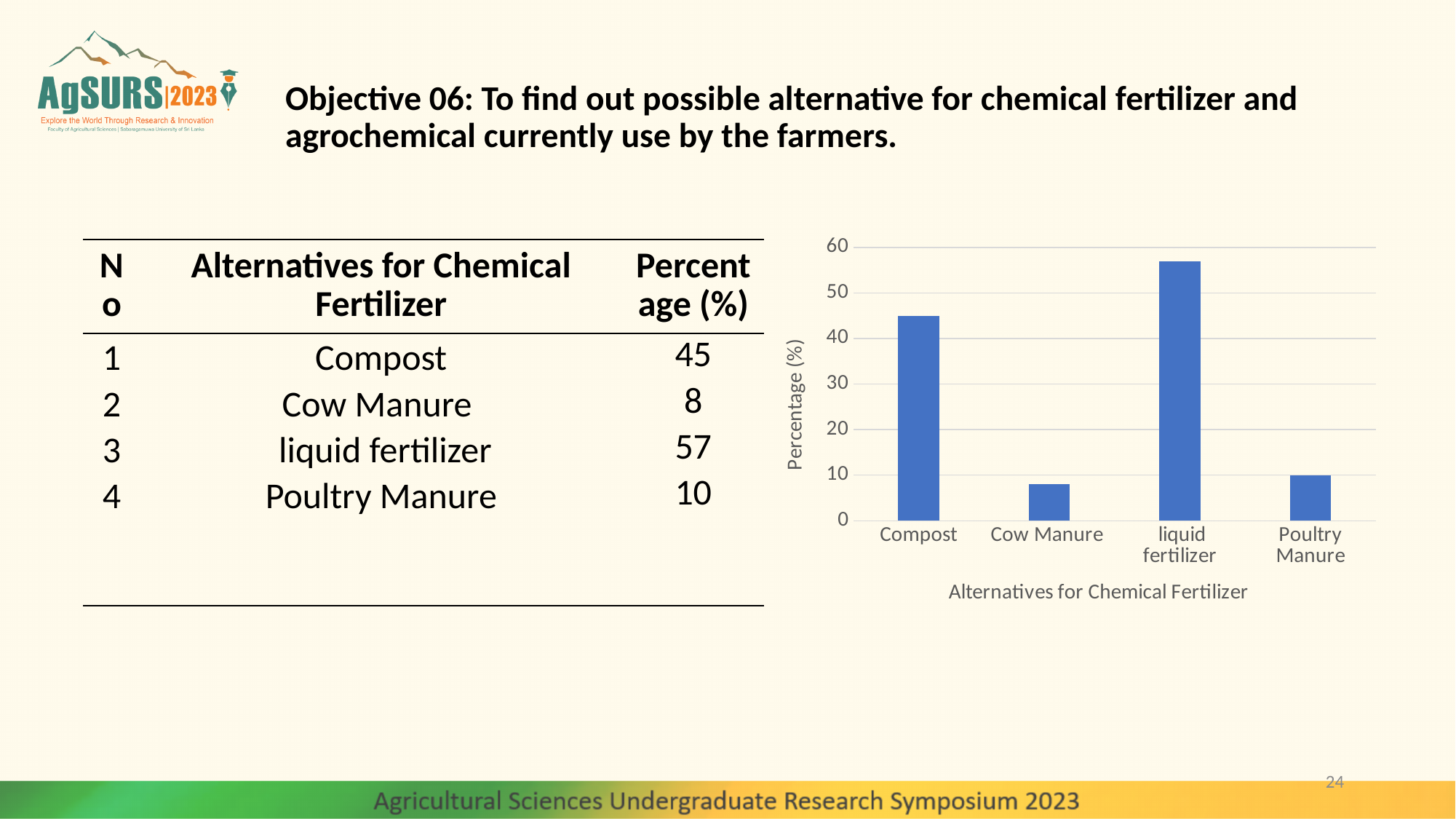
Which alternative for chemical fertilizer has the highest percentage in the chart? liquid fertilizer Which has a larger percentage, Compost or Poultry Manure? Compost Which alternative for chemical fertilizer has the lowest percentage in the chart? Cow Manure What is the percentage for liquid fertilizer? 57 Is the value for liquid fertilizer greater or less than 50? greater What kind of chart is shown on the slide? bar chart What is the percentage for Poultry Manure? 10 What is the percentage for Compost? 45 How many categories are shown on the x axis of the chart? 4 What is the difference in percentage between liquid fertilizer and Compost? 12 Is the value for Cow Manure greater or less than 10? less What is the label of the vertical axis of the chart? Percentage (%)